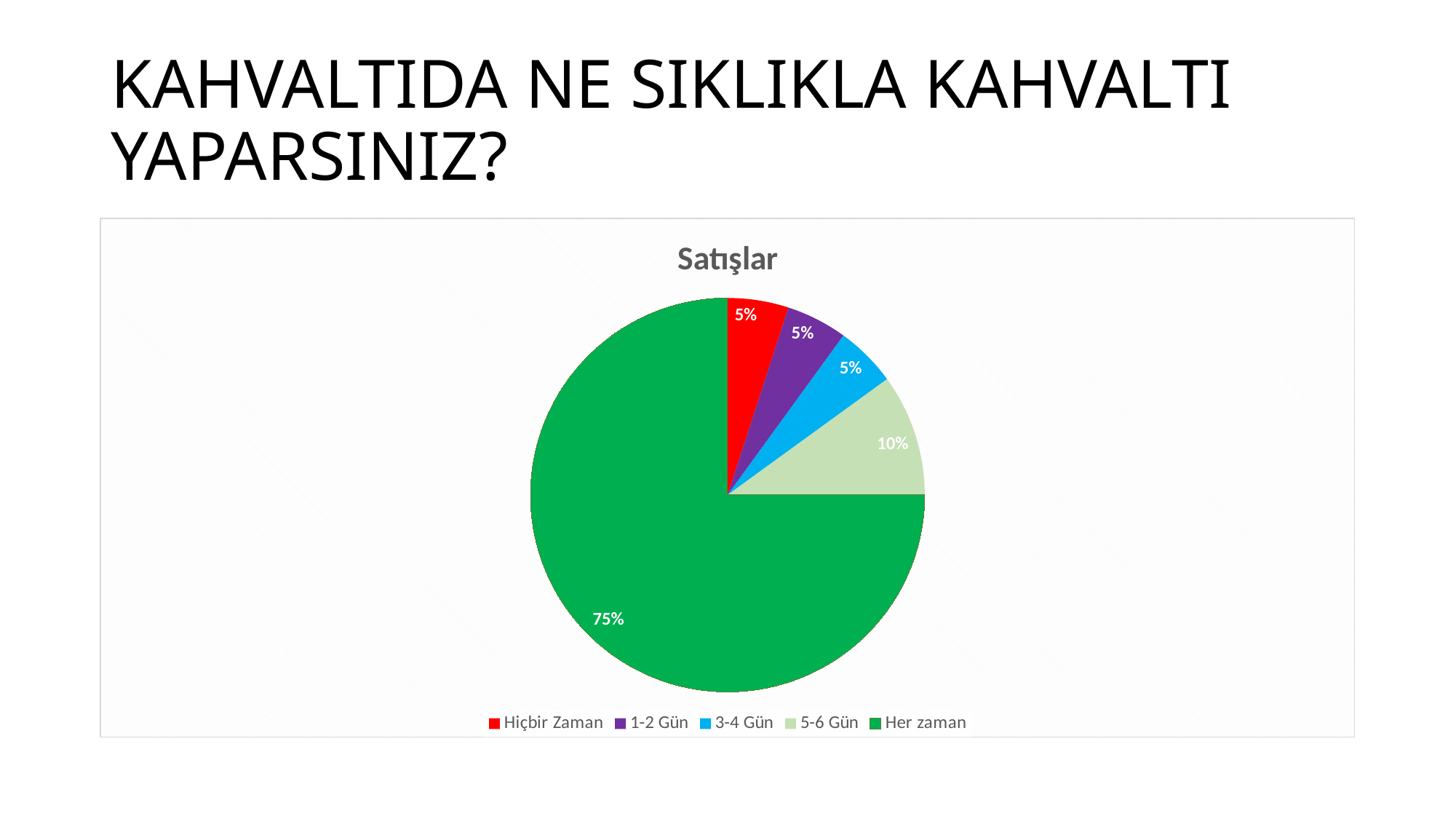
Which legend entry is shown in red? Hiçbir Zaman What share of the pie does 'Her zaman' take? 75% What kind of chart is shown on the slide? pie chart What share of the pie does '5-6 Gün' take? 10% What is the value for 'Hiçbir Zaman'? 5% Which is larger, the share for '5-6 Gün' or the share for '1-2 Gün'? 5-6 Gün What is the value for '3-4 Gün'? 5% How many slices does the pie chart have? 5 Which category has the largest slice? Her zaman What is the title of the chart? Satışlar What is the difference between the 'Her zaman' and '5-6 Gün' shares? 65% What is the combined share of 'Hiçbir Zaman', '1-2 Gün' and '3-4 Gün'? 15%